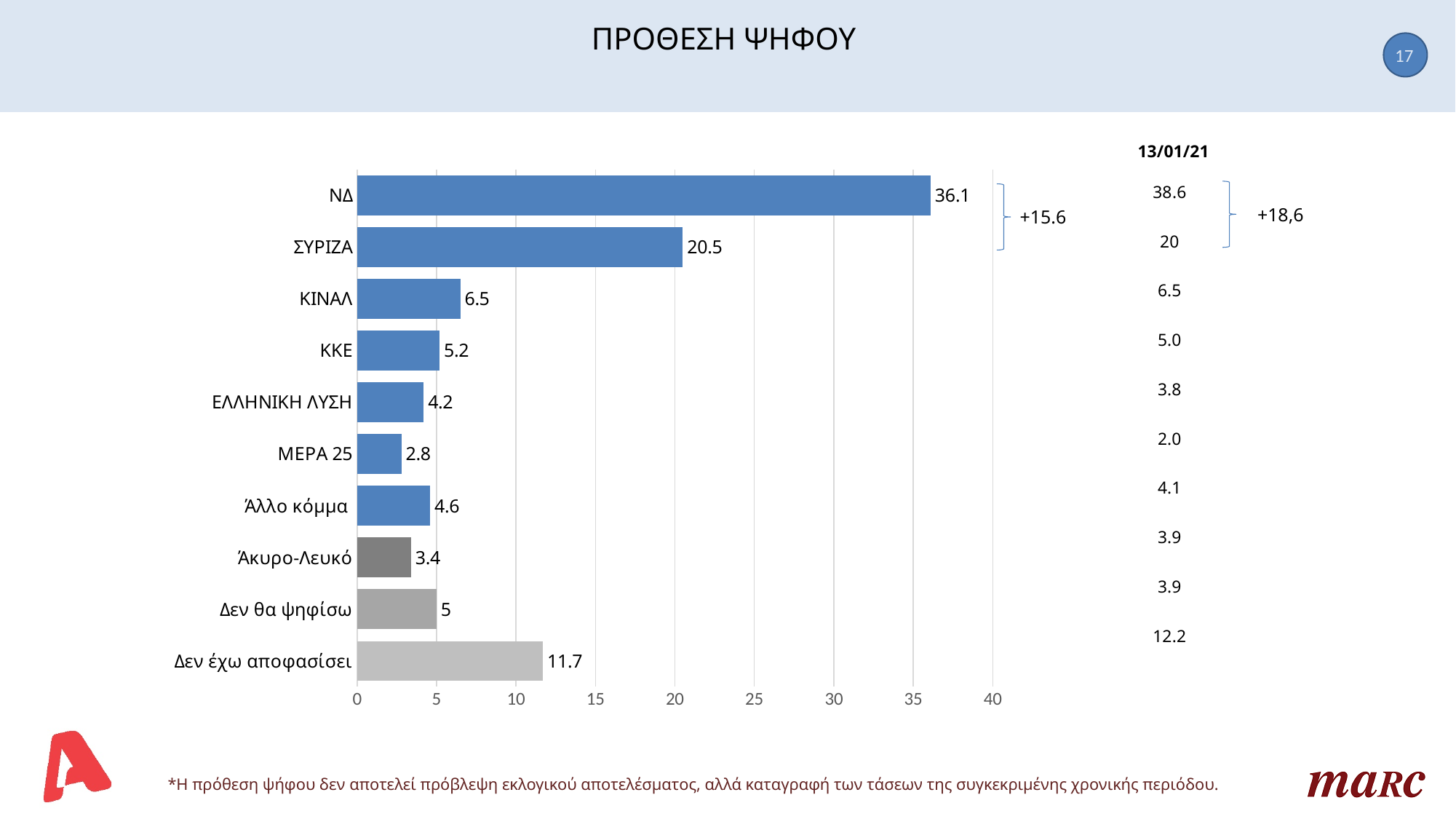
Which is larger, the value for ΚΙΝΑΛ or the value for ΚΚΕ? ΚΙΝΑΛ What is the title of the slide? ΠΡΟΘΕΣΗ ΨΗΦΟΥ What is the value for ΣΥΡΙΖΑ? 20.5 What is the value for Δεν έχω αποφασίσει? 11.7 Is the value for ΝΔ greater or less than 35? greater Which category has the lowest value? ΜΕΡΑ 25 What is the difference between the values for ΝΔ and ΣΥΡΙΖΑ? 15.6 Which category has the highest value? ΝΔ What is the value for ΜΕΡΑ 25? 2.8 What is the value for ΝΔ? 36.1 How many categories are shown in the chart? 10 What kind of chart is shown on the slide? bar chart